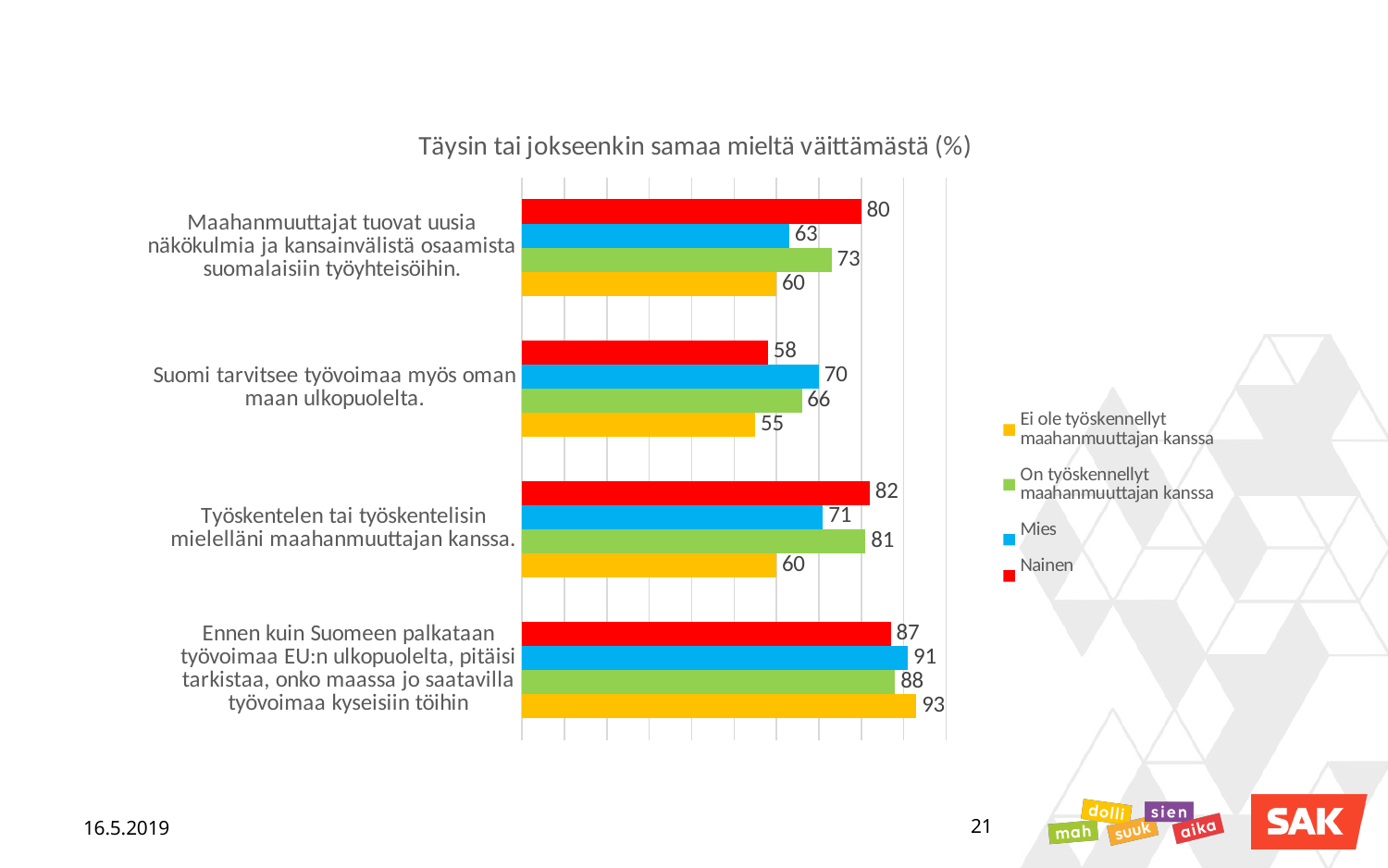
What type of chart is shown on the slide? Bar chart What is the value for "Ei ole työskennellyt maahanmuuttajan kanssa" for the statement "Ennen kuin Suomeen palkataan työvoimaa EU:n ulkopuolelta, pitäisi tarkistaa, onko maassa jo saatavilla työvoimaa kyseisiin töihin"? 93 How many statements (categories) are shown in the chart? 4 Which series has the highest value for the statement "Työskentelen tai työskentelisin mielelläni maahanmuuttajan kanssa."? Nainen How many series does the legend list? 4 What is the difference between the Nainen and Mies values for the statement "Maahanmuuttajat tuovat uusia näkökulmia ja kansainvälistä osaamista suomalaisiin työyhteisöihin."? 17 Which series has the lowest value for the statement "Suomi tarvitsee työvoimaa myös oman maan ulkopuolelta."? Ei ole työskennellyt maahanmuuttajan kanssa What is the value for Mies for the statement "Suomi tarvitsee työvoimaa myös oman maan ulkopuolelta."? 70 What is the title of the chart? Täysin tai jokseenkin samaa mieltä väittämästä (%) What is the value for "On työskennellyt maahanmuuttajan kanssa" for the statement "Työskentelen tai työskentelisin mielelläni maahanmuuttajan kanssa."? 81 For the statement "Ennen kuin Suomeen palkataan työvoimaa EU:n ulkopuolelta, pitäisi tarkistaa, onko maassa jo saatavilla työvoimaa kyseisiin töihin", which is larger: the value for Mies or the value for Nainen? Mies What is the value for Nainen for the statement "Maahanmuuttajat tuovat uusia näkökulmia ja kansainvälistä osaamista suomalaisiin työyhteisöihin."? 80